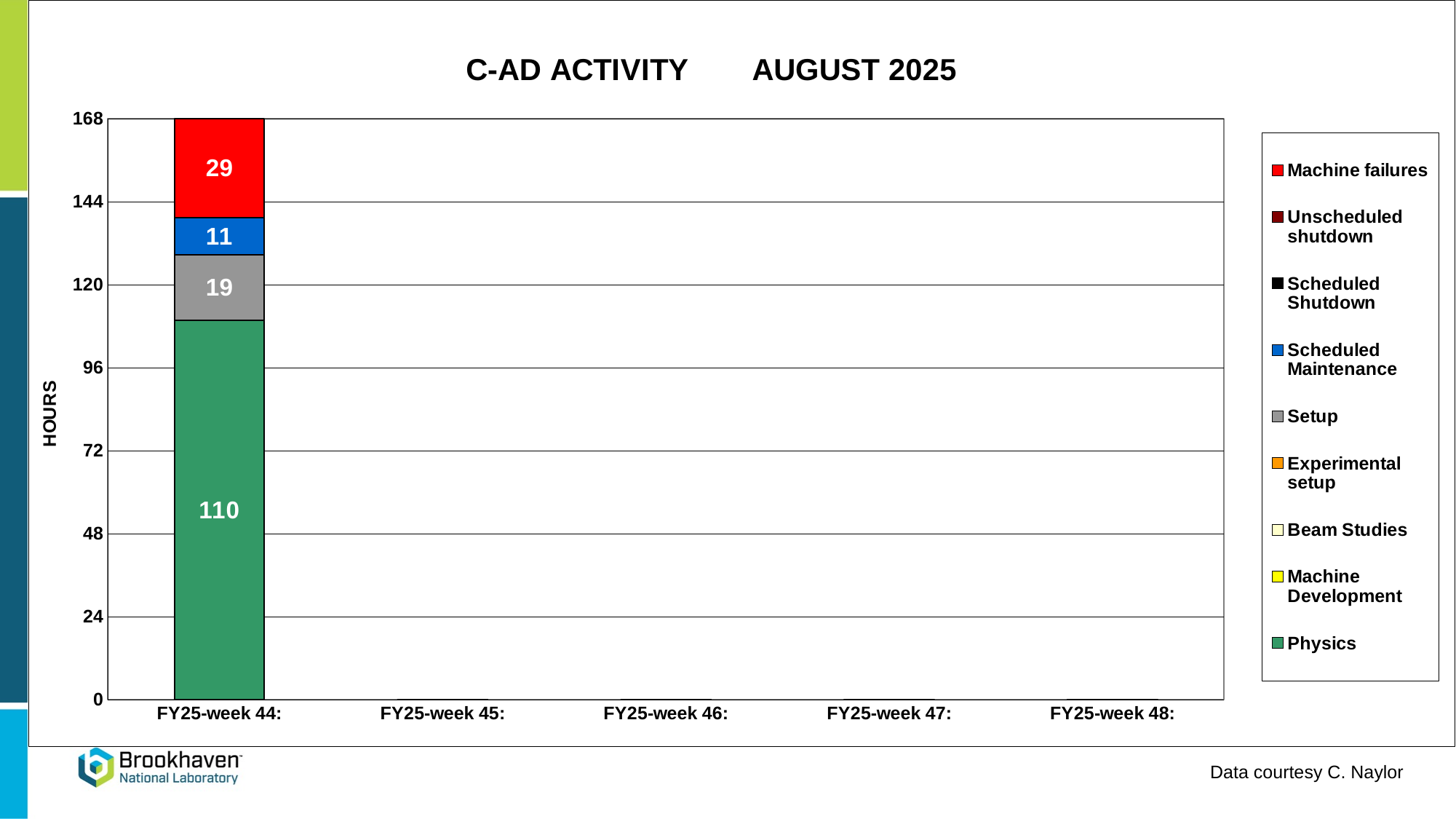
How many week categories are shown on the x axis? 5 What is the title of the chart? C-AD ACTIVITY AUGUST 2025 How many series does the legend list? 9 How many hours of Machine failures are shown for FY25-week 44? 29 Which activity has the largest number of hours in FY25-week 44? Physics How many hours of Physics are shown for FY25-week 44? 110 How many hours of Scheduled Maintenance are shown for FY25-week 44? 11 In FY25-week 44, which has more hours: Machine failures or Scheduled Maintenance? Machine failures What is the difference in hours between Machine failures and Setup in FY25-week 44? 10 Which of the labelled activities has the fewest hours in FY25-week 44? Scheduled Maintenance What type of chart is shown on the slide? Stacked bar chart How many hours of Setup are shown for FY25-week 44? 19